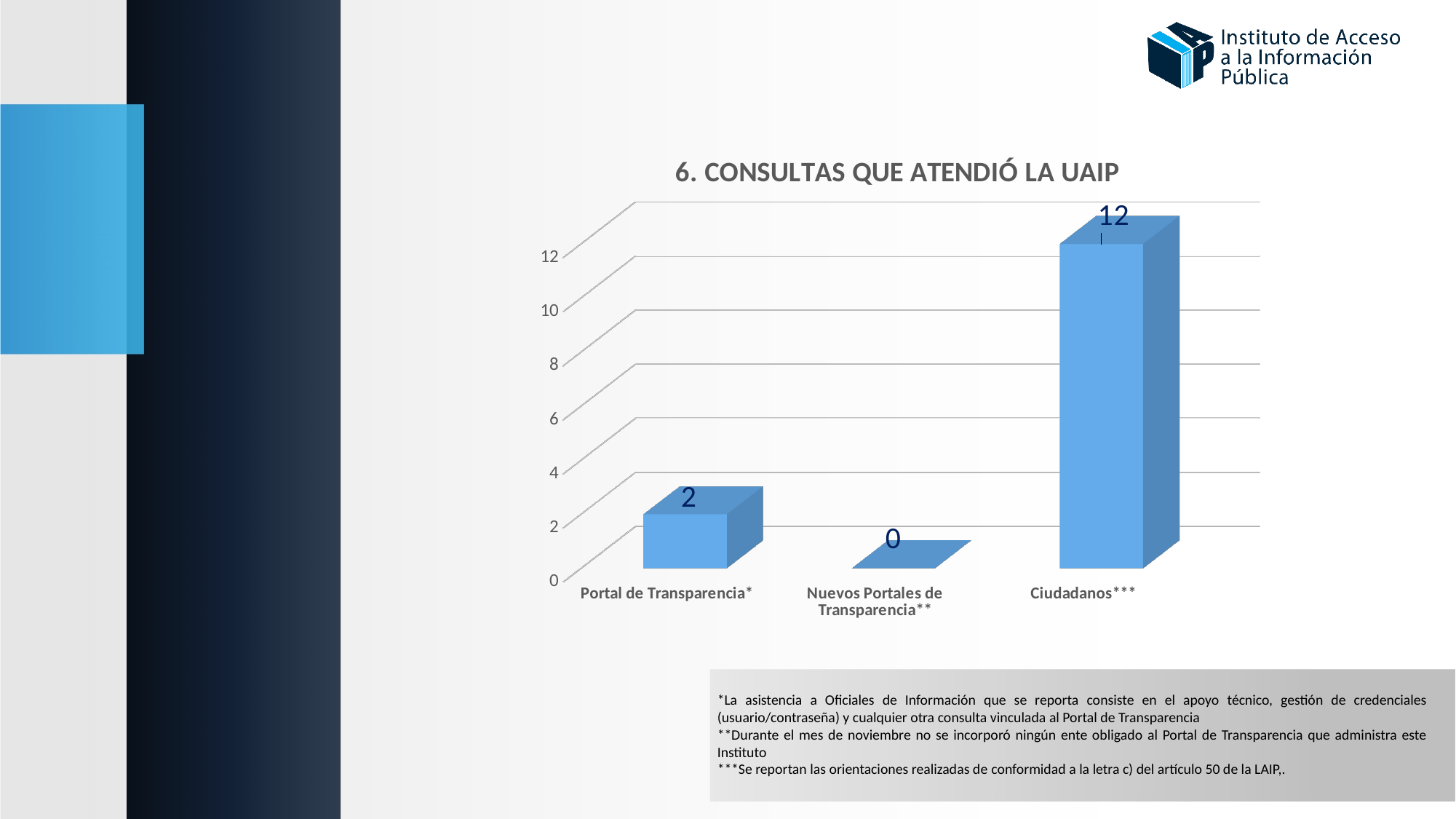
What is the value for Portal de Transparencia*? 2 What is the highest value shown on the vertical axis? 12 Which category has the lowest value? Nuevos Portales de Transparencia** What kind of chart is shown on the slide? bar chart Which is larger, the value for Portal de Transparencia* or the value for Ciudadanos***? Ciudadanos*** What is the value for Nuevos Portales de Transparencia**? 0 How many categories are shown on the x axis? 3 Is the value for Ciudadanos*** greater or less than 10? greater Which category has the highest value? Ciudadanos*** What is the difference between the values for Ciudadanos*** and Portal de Transparencia*? 10 What is the title of the chart? 6. CONSULTAS QUE ATENDIÓ LA UAIP What is the value for Ciudadanos***? 12